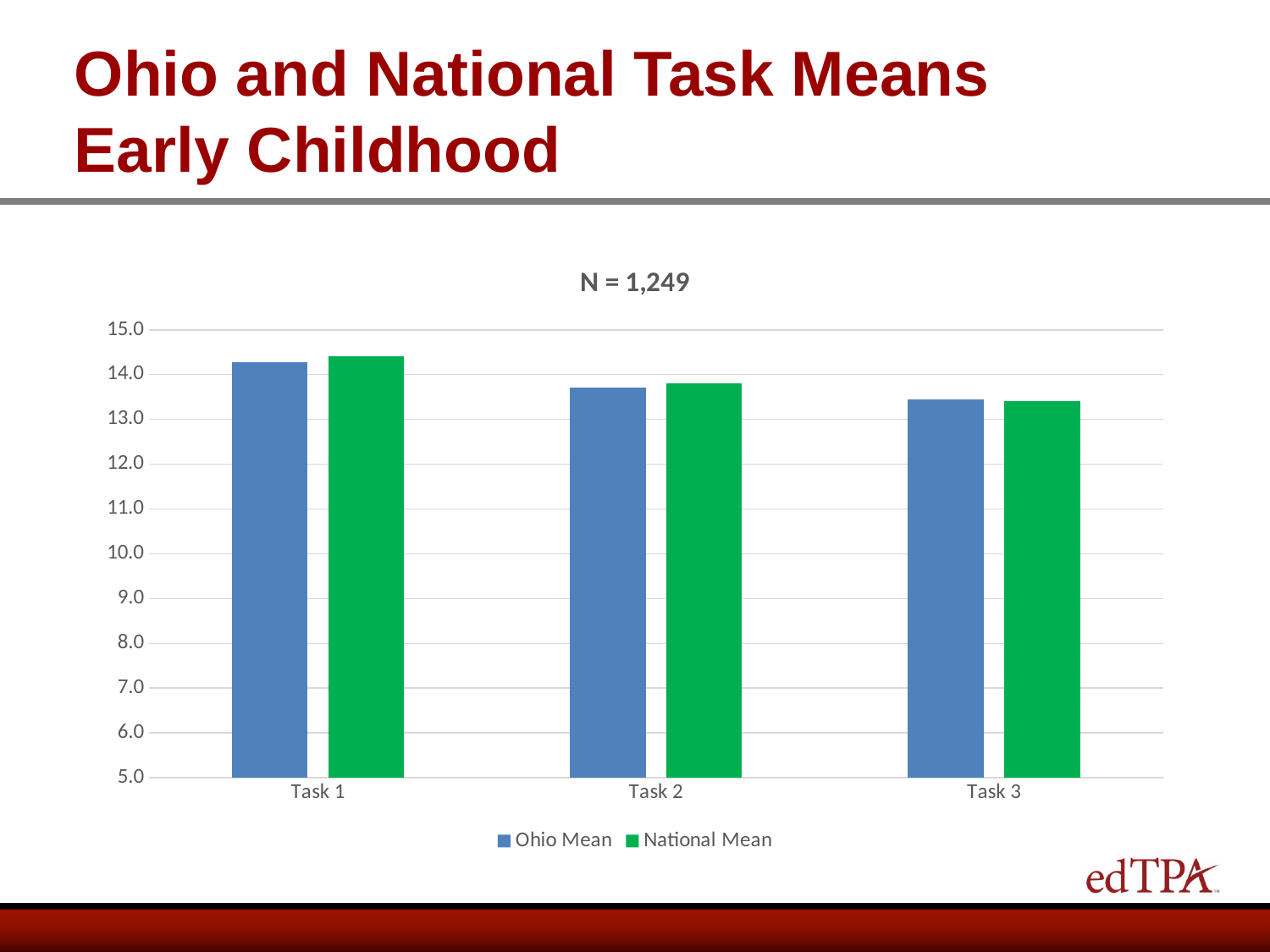
Is the Ohio Mean for Task 3 greater or less than 13.0? greater Do the National Mean values rise or fall from Task 1 to Task 3? fall What kind of chart is shown on the slide? Bar chart Which task has the highest National Mean? Task 1 What is the title shown above the chart? N = 1,249 Which task has the highest Ohio Mean? Task 1 How many series does the chart legend list? 2 Which task has the lowest National Mean? Task 3 Is the Ohio Mean for Task 1 greater or less than 14.0? greater Is the National Mean for Task 2 greater or less than 14.0? less How many tasks are shown on the x axis of the chart? 3 Which colour represents the Ohio Mean in the chart? Blue